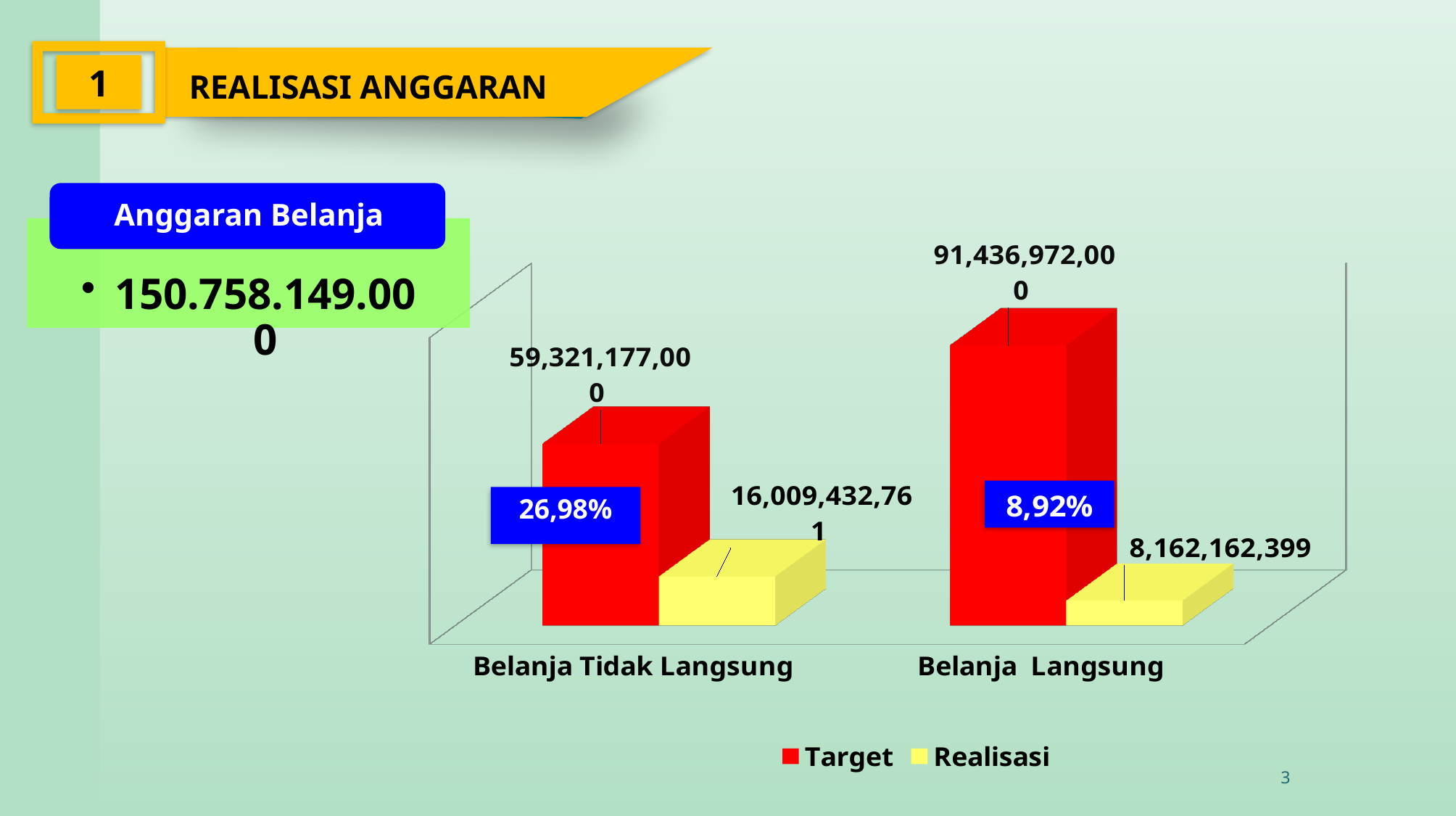
What is the difference between the Target and Realisasi values for Belanja Tidak Langsung? 43,311,744,239 Which category has the highest Target value? Belanja Langsung What kind of chart is shown on the slide? Bar chart Which category has the lowest Realisasi value? Belanja Langsung How many categories are shown on the x axis of the chart? 2 What is the Realisasi value for Belanja Langsung? 8,162,162,399 What is the Target value for Belanja Langsung? 91,436,972,000 Which is larger, the Realisasi value for Belanja Tidak Langsung or the Realisasi value for Belanja Langsung? Belanja Tidak Langsung How many series does the chart legend list? 2 What is the Target value for Belanja Tidak Langsung? 59,321,177,000 What is the Realisasi value for Belanja Tidak Langsung? 16,009,432,761 What is the difference between the Target values for Belanja Langsung and Belanja Tidak Langsung? 32,115,795,000